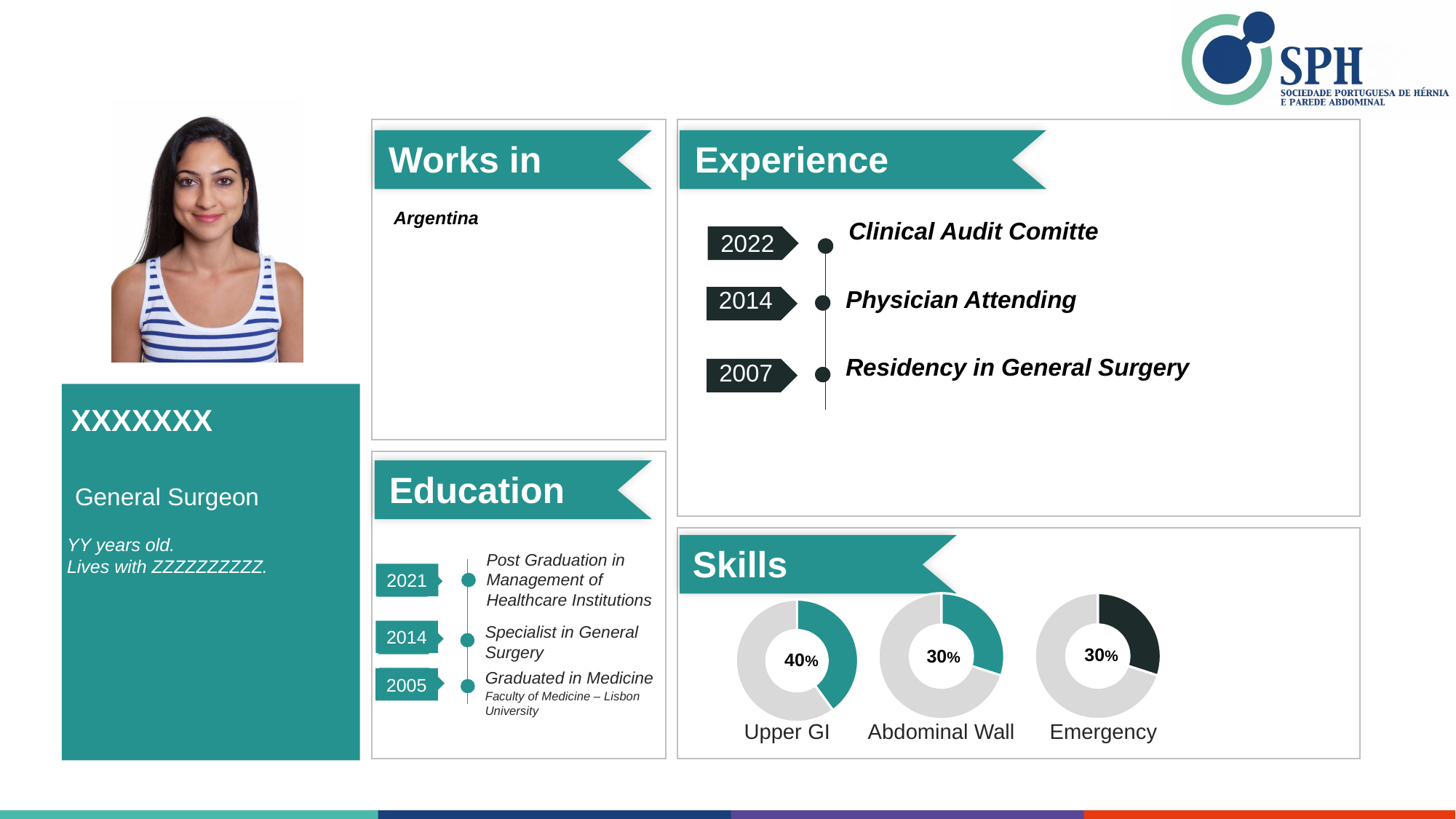
How many donut charts are shown in the Skills section? 3 In the Skills section, what value is shown in the Emergency donut chart? 30% In the Skills section, what value is shown in the Abdominal Wall donut chart? 30% In the Skills section, what value is shown in the Upper GI donut chart? 40% In the Skills section, which is larger: the Upper GI value or the Abdominal Wall value? Upper GI In the Skills section, is the Upper GI value greater or less than 50%? less In the Skills section, do the Abdominal Wall and Emergency charts show the same percentage? Yes, both 30% In the Skills section, which donut chart uses a dark (near-black) colour for its filled segment instead of teal? Emergency What kind of chart is used to show each skill in the Skills section? Donut (pie) chart What is the title of the section containing the three donut charts? Skills In the Skills section, what is the difference between the Upper GI percentage and the Emergency percentage? 10% Among the three Skills donut charts, which skill has the highest percentage? Upper GI